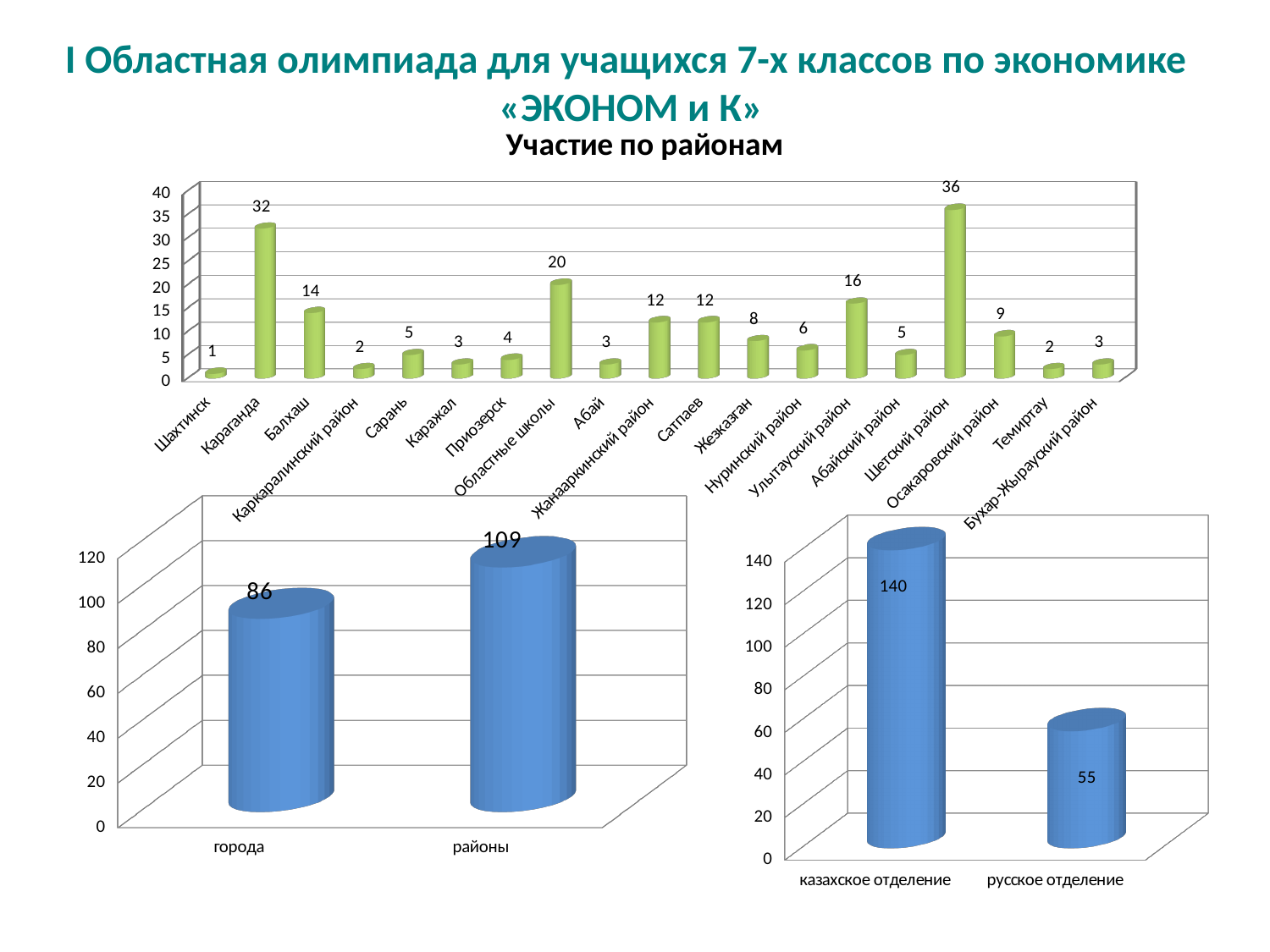
What type of chart is the bottom-right chart? bar chart In the top chart 'Участие по районам', which category has the highest value? Шетский район In the top chart 'Участие по районам', which is larger, the value for Балхаш or the value for Улытауский район? Улытауский район In the bottom-right chart, what is the value for русское отделение? 55 In the top chart 'Участие по районам', what is the value for Караганда? 32 How many categories are shown in the top chart 'Участие по районам'? 19 In the bottom-right chart, which is larger, казахское отделение or русское отделение? казахское отделение In the bottom-left chart, what is the difference between the values for районы and города? 23 In the top chart 'Участие по районам', what is the value for Областные школы? 20 In the top chart 'Участие по районам', what is the difference between the values for Шетский район and Караганда? 4 In the bottom-left chart, what is the value for районы? 109 In the top chart 'Участие по районам', which category has the lowest value? Шахтинск